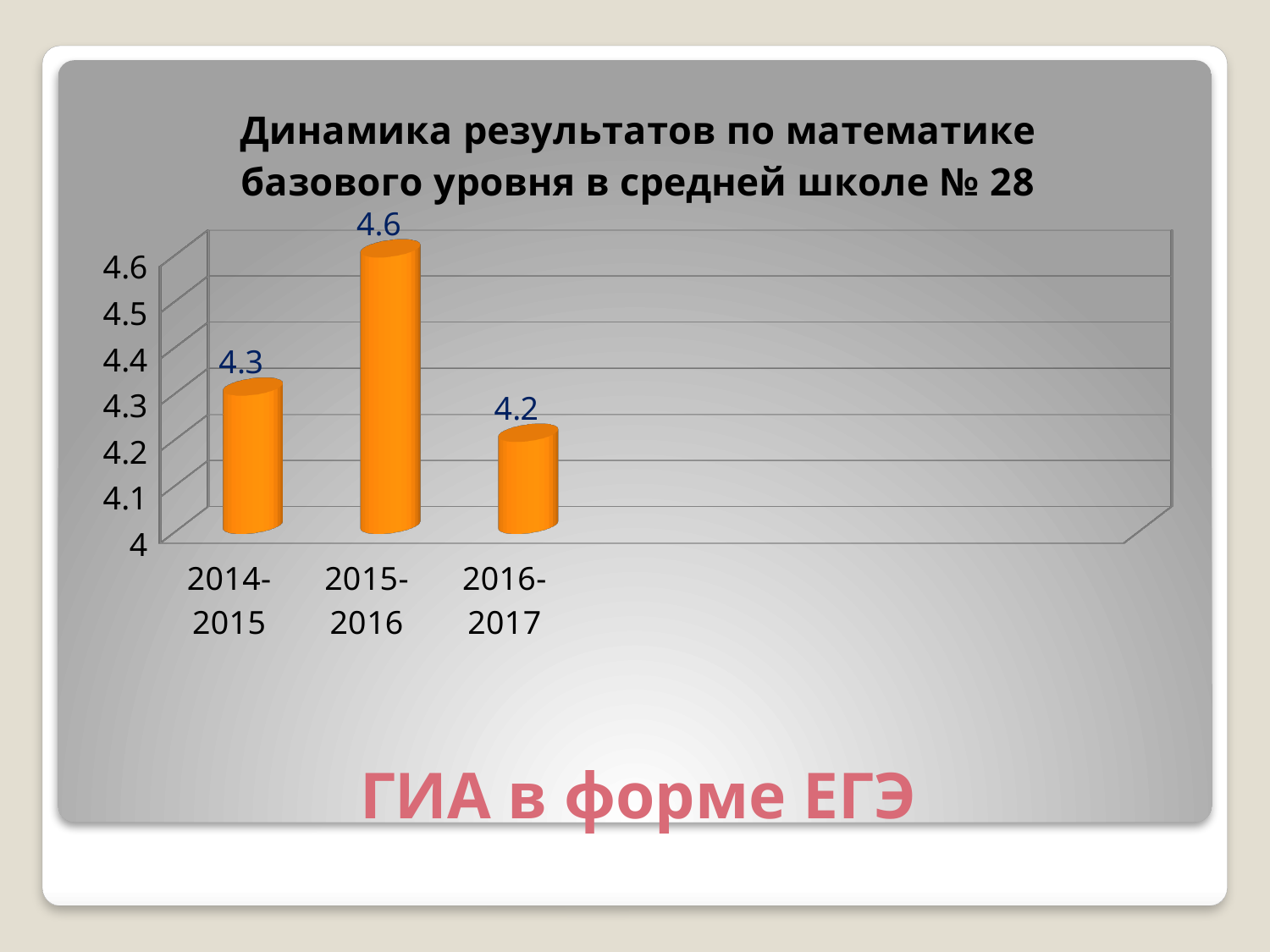
What is the difference between the values for 2014-2015 and 2016-2017? 0.1 What is the value for 2016-2017? 4.2 Which year has the highest value? 2015-2016 How many categories are shown on the x axis? 3 What is the title of the chart? Динамика результатов по математике базового уровня в средней школе № 28 What is the value for 2014-2015? 4.3 Which year has the lowest value? 2016-2017 Which is larger, the value for 2014-2015 or the value for 2016-2017? 2014-2015 Is the value for 2015-2016 greater or less than 4.5? greater What is the difference between the values for 2015-2016 and 2014-2015? 0.3 What kind of chart is shown on the slide? bar chart What is the value for 2015-2016? 4.6